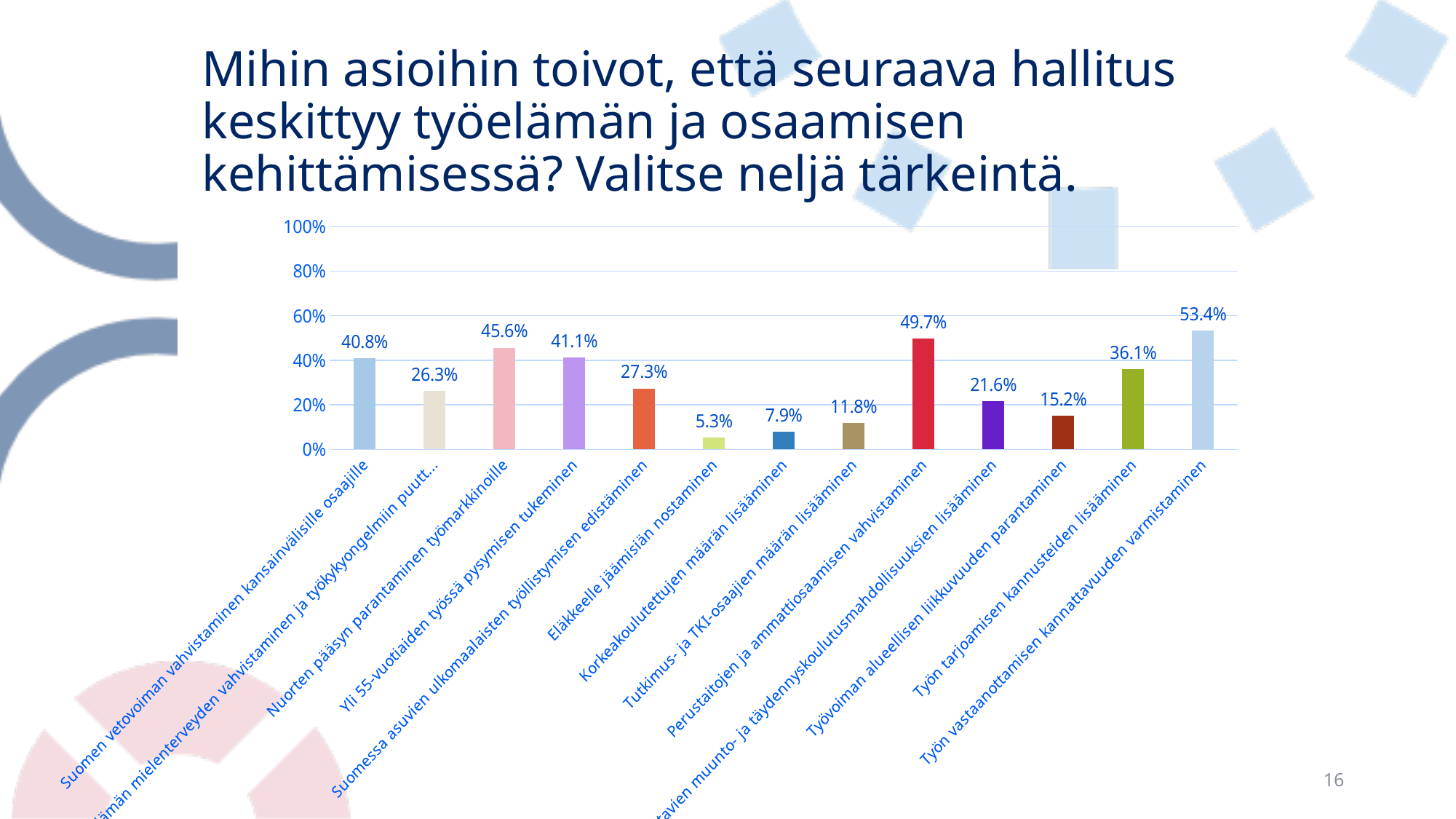
What percentage is shown for "Nuorten pääsyn parantaminen työmarkkinoille"? 45.6% What value is shown for "Eläkkeelle jäämisiän nostaminen"? 5.3% What type of chart is shown on the slide? Bar chart What percentage is shown for "Työn vastaanottamisen kannattavuuden varmistaminen"? 53.4% What is the highest value shown on the vertical axis of the chart? 100% Which is larger: the value for "Suomen vetovoiman vahvistaminen kansainvälisille osaajille" or for "Yli 55-vuotiaiden työssä pysymisen tukeminen"? Yli 55-vuotiaiden työssä pysymisen tukeminen Which category has the lowest value in the chart? Eläkkeelle jäämisiän nostaminen What value is shown for "Työvoiman alueellisen liikkuvuuden parantaminen"? 15.2% What is the difference between the values for "Perustaitojen ja ammattiosaamisen vahvistaminen" and "Työn tarjoamisen kannusteiden lisääminen"? 13.6% Is the value for "Korkeakoulutettujen määrän lisääminen" greater or less than 20%? less Which category has the highest value in the chart? Työn vastaanottamisen kannattavuuden varmistaminen How many bars are plotted in the chart? 13